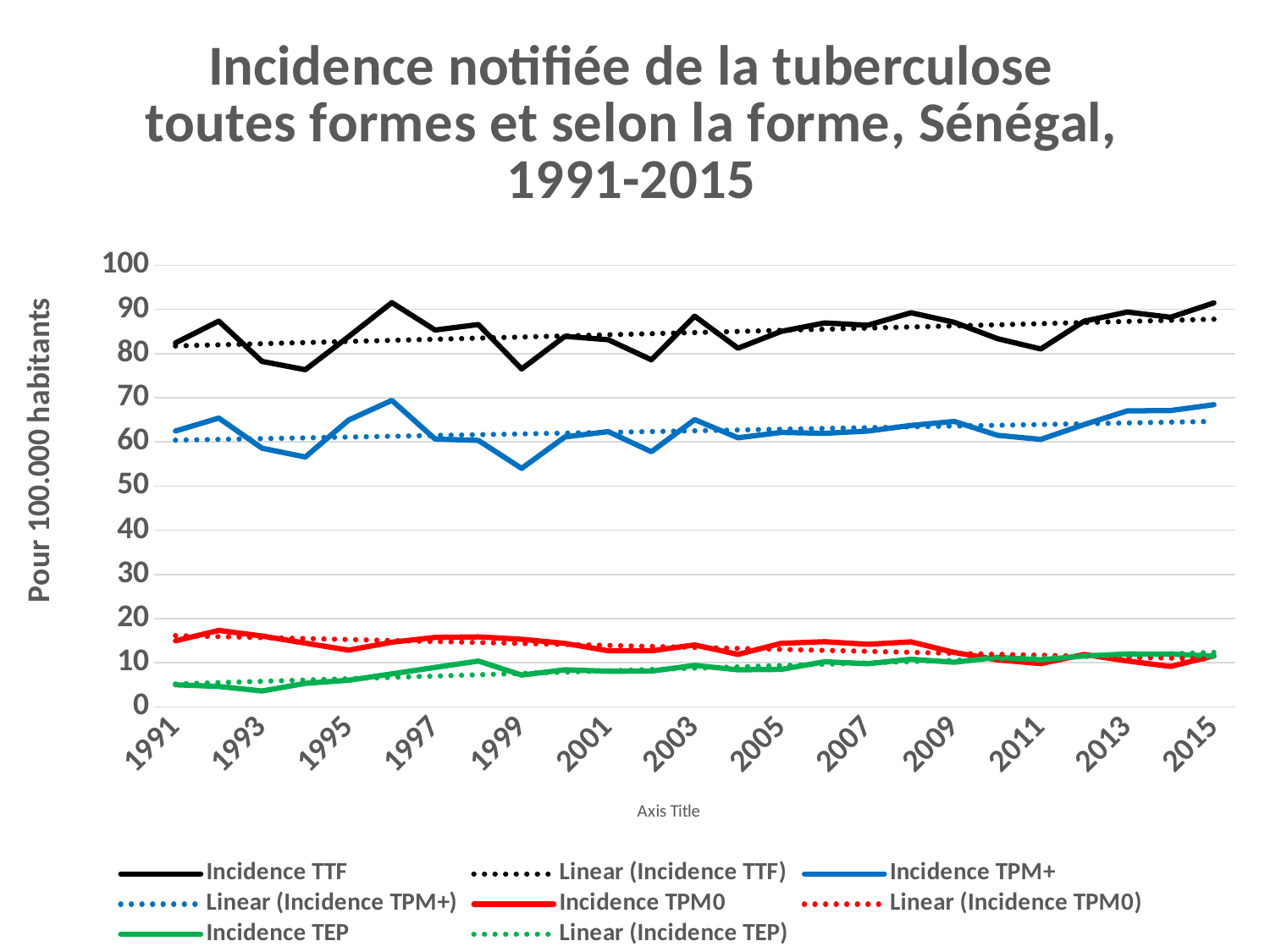
Is the value for Incidence TTF in 1999 greater or less than 80? less Which series has the highest values across the whole period? Incidence TTF How many year labels are shown on the x axis? 13 Is the value for Incidence TTF in 2015 greater or less than 80? greater What kind of chart is shown on the slide? line chart Is the value for Incidence TEP in 1993 greater or less than 10? less How many series does the legend list? 8 Does Incidence TEP generally rise or fall from 1991 to 2015? rise Which series has the lowest value in 1991? Incidence TEP Which is larger in 1991, Incidence TPM0 or Incidence TEP? Incidence TPM0 What is the title of the vertical axis? Pour 100.000 habitants